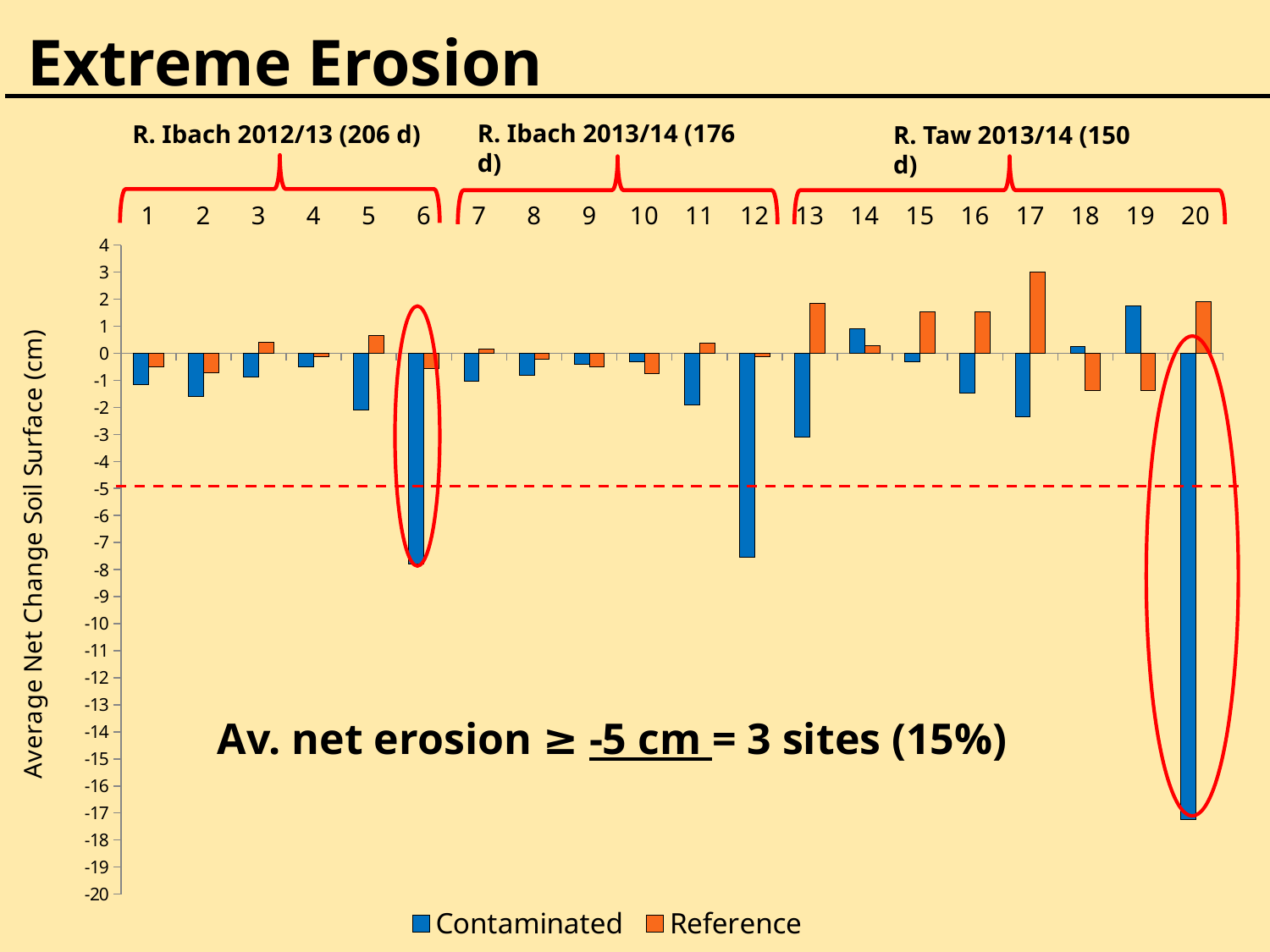
Is the Reference value for site 17 greater or less than 2? greater Is the Contaminated value for site 6 greater or less than -5? less How many sites are plotted along the x axis? 20 What are the two series named in the legend? Contaminated and Reference Is the Contaminated value for site 13 greater or less than -2? less How many series does the legend list? 2 Which site has the highest Reference value? 17 Which site has the lowest Contaminated value? 20 How many sites have average net erosion of -5 cm or more, according to the slide? 3 sites (15%) Which is larger, the Contaminated value for site 6 or for site 20? site 6 What kind of chart is shown on the slide? bar chart